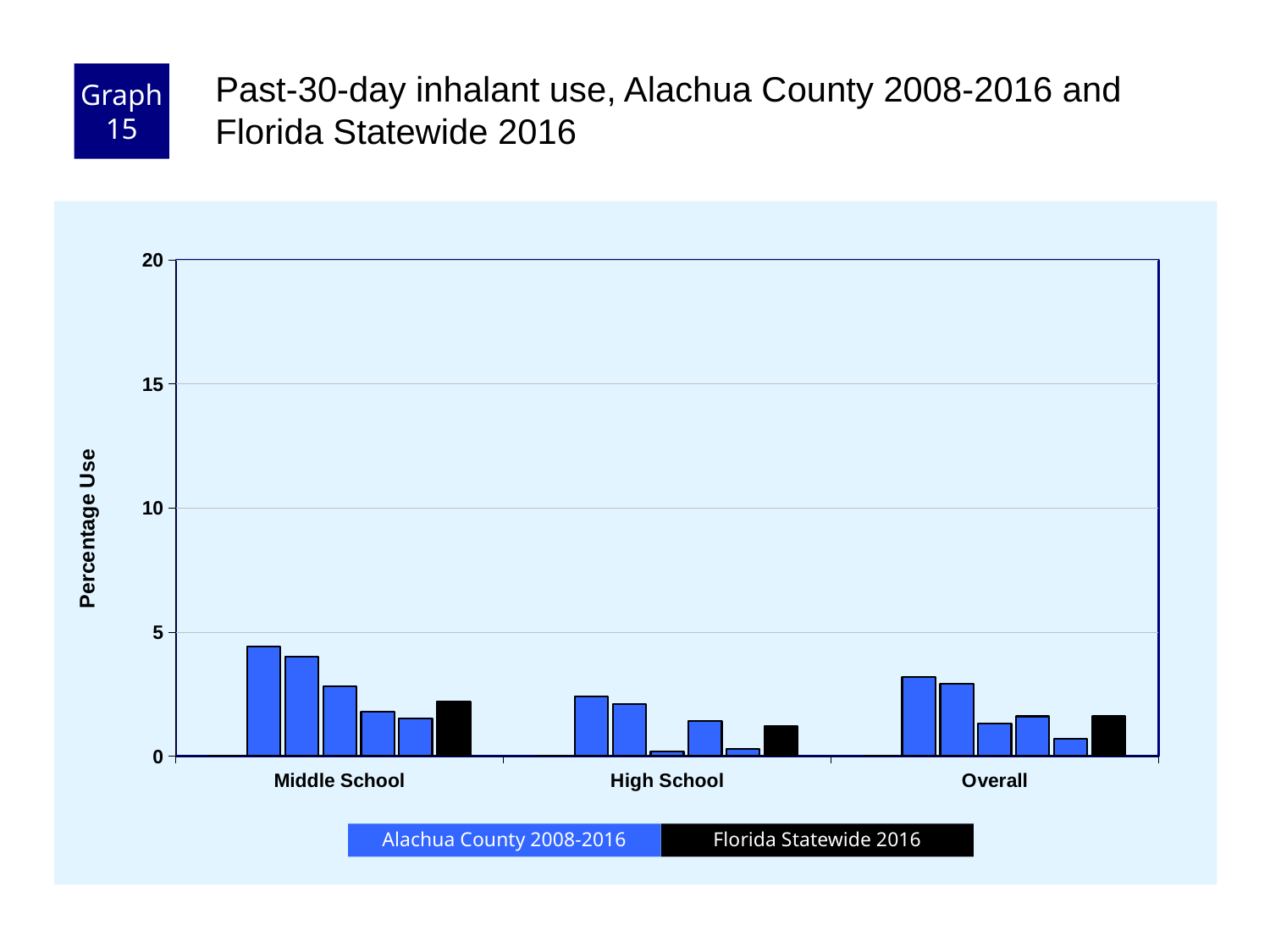
Is the Florida Statewide 2016 bar for High School greater or less than 5? less What kind of chart is shown on the slide? bar chart Which is larger: the Florida Statewide 2016 bar for Middle School or for High School? Middle School How many series does the legend list? 2 Which category has the lowest Florida Statewide 2016 bar? High School Do the Alachua County bars for Middle School rise or fall from left to right? fall How many categories are shown on the x axis? 3 What are the two series named in the legend? Alachua County 2008-2016 and Florida Statewide 2016 What is the label on the vertical axis? Percentage Use Which category has the highest Florida Statewide 2016 bar? Middle School Is the Florida Statewide 2016 bar for Overall greater or less than 10? less Is the tallest Alachua County bar for Middle School greater or less than 5? less